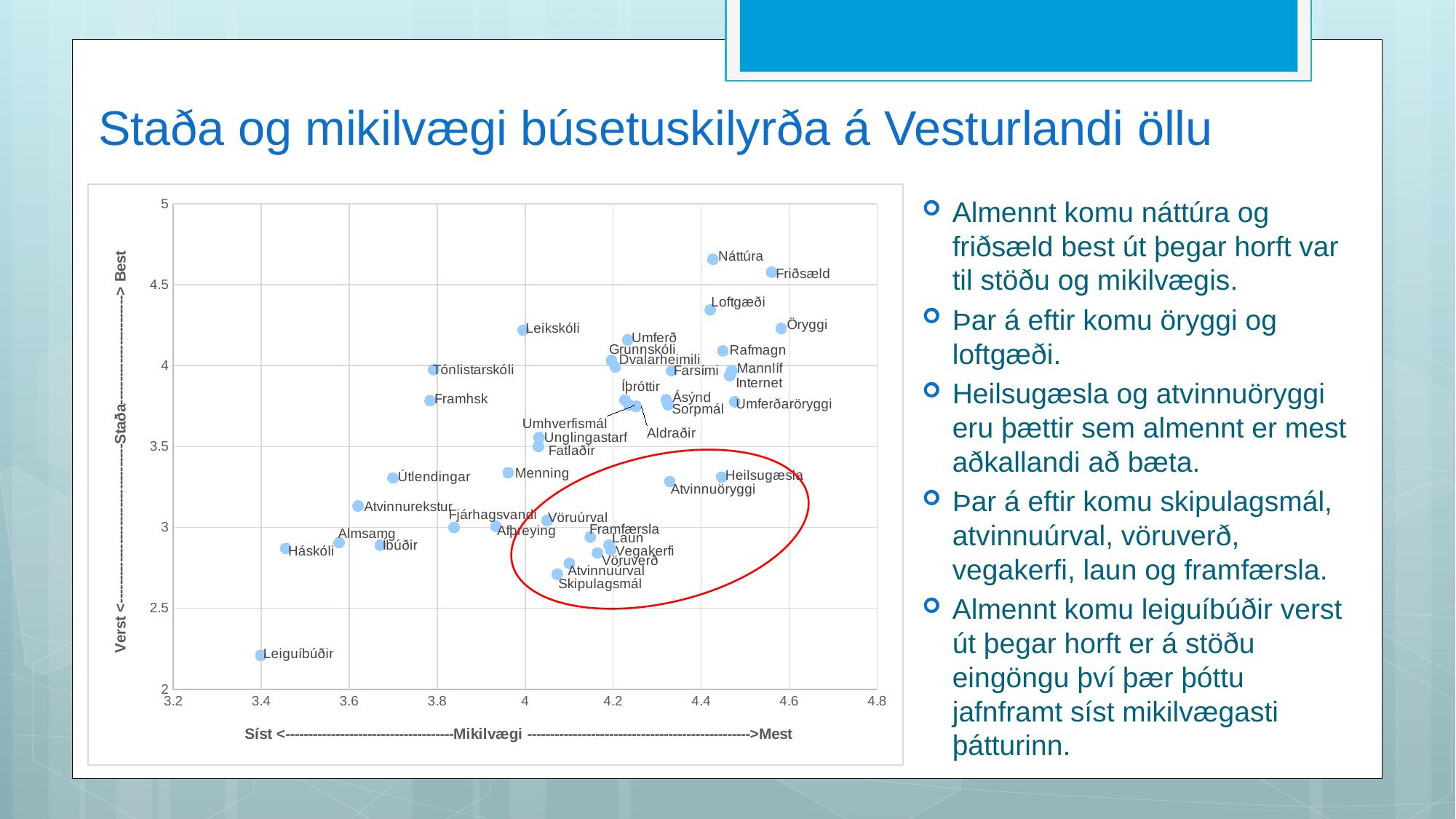
Is the Mikilvægi value for Háskóli greater or less than 3.6? less Which has the higher Mikilvægi value, Háskóli or Heilsugæsla? Heilsugæsla Is the Mikilvægi value for Öryggi greater or less than 4.4? greater Which point has the lowest value on the Mikilvægi (horizontal) axis? Leiguíbúðir Is the Staða value for Náttúra greater or less than 4.5? greater Which point has the lowest value on the Staða (vertical) axis? Leiguíbúðir What is the title of the slide containing the chart? Staða og mikilvægi búsetuskilyrða á Vesturlandi öllu Which point has the highest value on the Staða (vertical) axis? Náttúra What kind of chart is shown on the slide? Scatter chart Which has the higher Staða value, Leikskóli or Útlendingar? Leikskóli